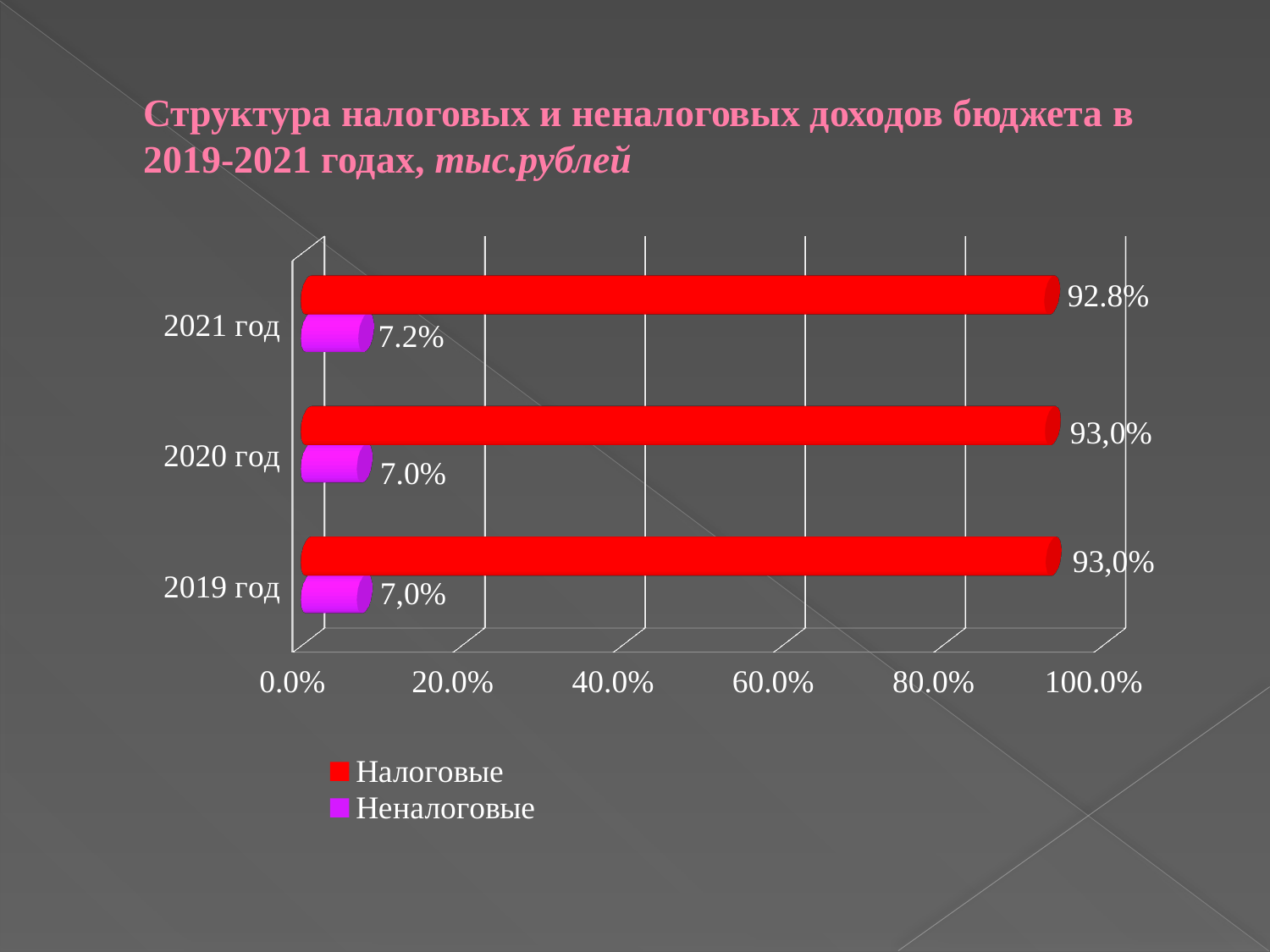
How many years are shown on the chart? 3 What is the value for Неналоговые in 2021 год? 7.2% What is the difference between the Налоговые and Неналоговые values in 2021 год? 85.6% In which year is the Неналоговые value highest? 2021 год In which year is the Налоговые value lowest? 2021 год What is the value for Налоговые in 2021 год? 92.8% What is the value for Неналоговые in 2019 год? 7,0% What is the value for Налоговые in 2020 год? 93,0% Is the value for Налоговые in 2019 год greater or less than 80.0%? greater What kind of chart is shown on the slide? bar chart How many series does the legend list? 2 Which is larger in 2020 год, Налоговые or Неналоговые? Налоговые